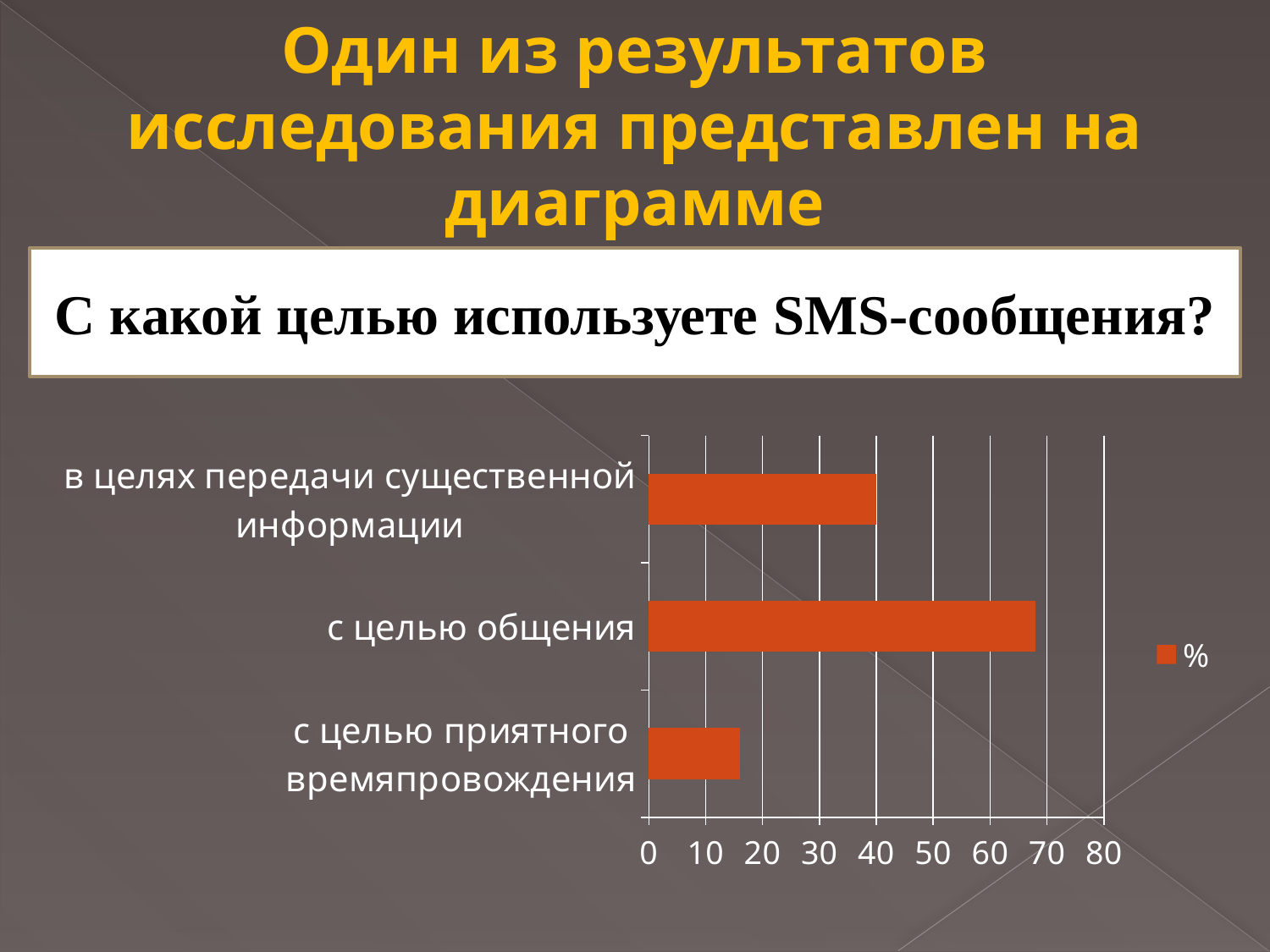
How many categories are shown in the chart? 3 Is the value for 'в целях передачи существенной информации' greater or less than 30? greater Is the value for 'с целью общения' greater or less than 60? greater Which category has the highest value? с целью общения What kind of chart is shown on the slide? bar chart Is the value for 'с целью приятного времяпровождения' greater or less than 20? less What is the legend entry for the series in the chart? % Which category has the lowest value? с целью приятного времяпровождения How many series does the legend list? 1 What question does the chart present results for? С какой целью используете SMS-сообщения? Which is larger: the value for 'с целью общения' or the value for 'в целях передачи существенной информации'? с целью общения What is the value for 'в целях передачи существенной информации'? 40